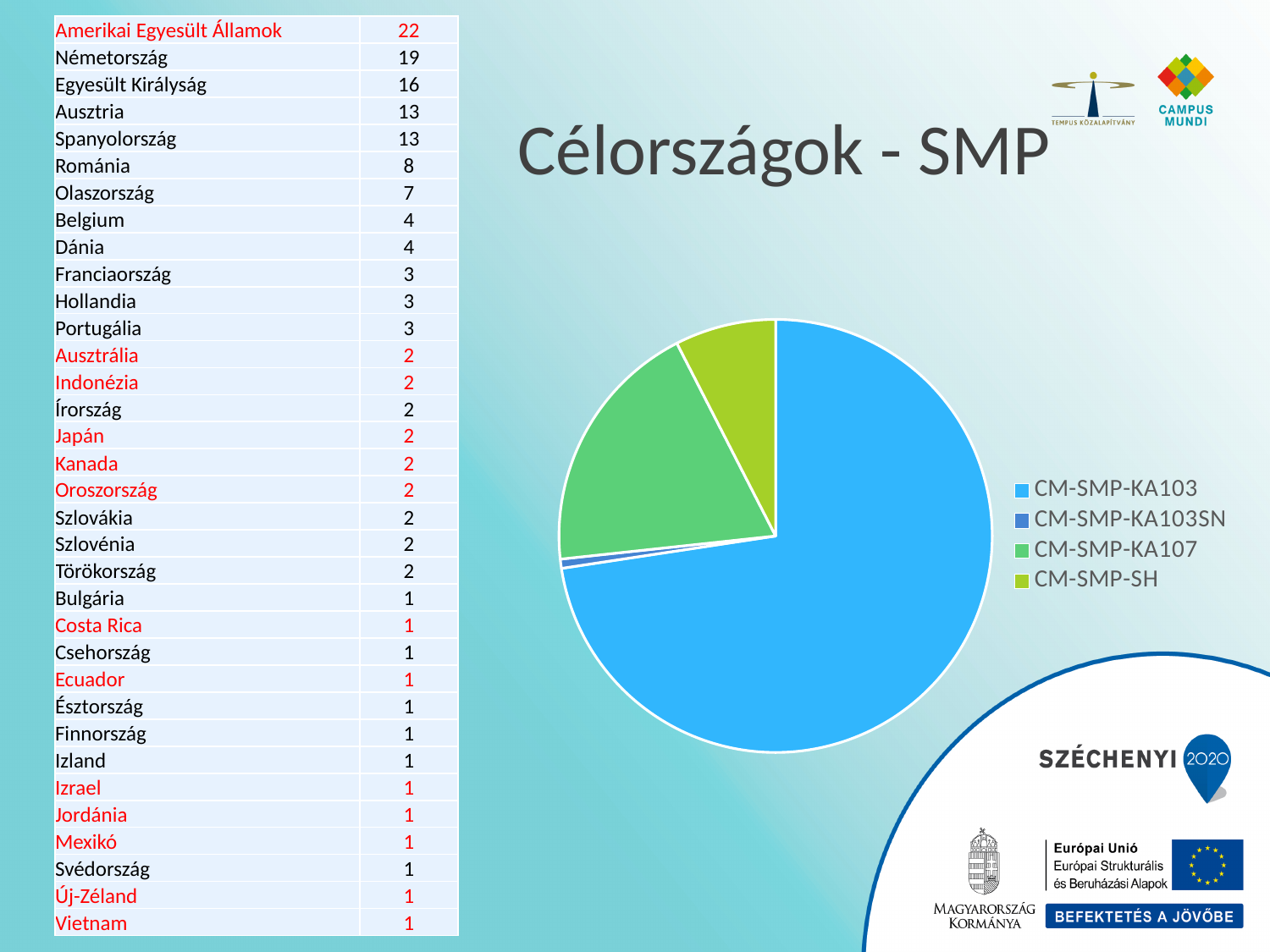
Which slice is larger in the pie chart, CM-SMP-KA107 or CM-SMP-SH? CM-SMP-KA107 Which category has the smallest slice in the pie chart? CM-SMP-KA103SN Which legend entry in the pie chart is shown in yellow-green? CM-SMP-SH Does the largest slice of the pie chart take up more or less than half of the pie? more How many categories does the pie chart's legend list? 4 What kind of chart is shown on the slide? pie chart Which slice is larger in the pie chart, CM-SMP-KA103 or CM-SMP-KA107? CM-SMP-KA103 Which category has the largest slice in the pie chart? CM-SMP-KA103 What is the title of the slide containing the pie chart? Célországok - SMP Which slice is larger in the pie chart, CM-SMP-SH or CM-SMP-KA103SN? CM-SMP-SH